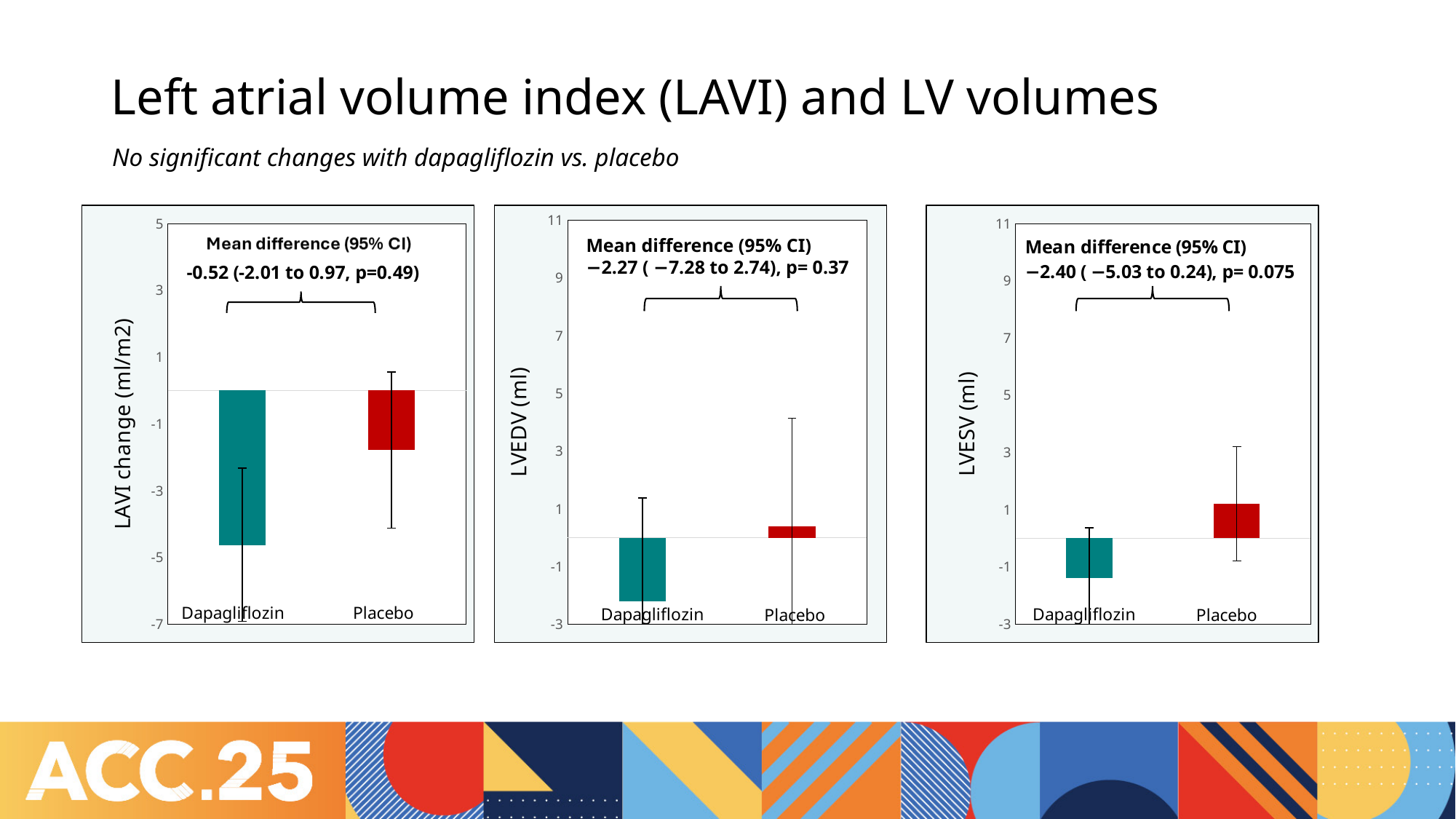
What kind of chart is the LAVI change chart on the left? bar chart In the LAVI change chart, is the value for Placebo greater or less than -3? greater In the LVESV chart, what mean difference (95% CI) is printed? −2.40 ( −5.03 to 0.24), p= 0.075 How many categories are shown on the x axis of the LVEDV chart? 2 In the LAVI change chart, which category has the lower bar, Dapagliflozin or Placebo? Dapagliflozin In the LVEDV chart, what p-value is printed for the mean difference? p= 0.37 In the LAVI change chart, is the value for Dapagliflozin greater or less than -3? less In the LAVI change chart, what mean difference (95% CI) is printed? -0.52 (-2.01 to 0.97, p=0.49) In the LVEDV chart, is the value for Dapagliflozin greater or less than -1? less In the LVESV chart, which category has the higher bar, Dapagliflozin or Placebo? Placebo What is the y-axis label of the chart on the left? LAVI change (ml/m2)